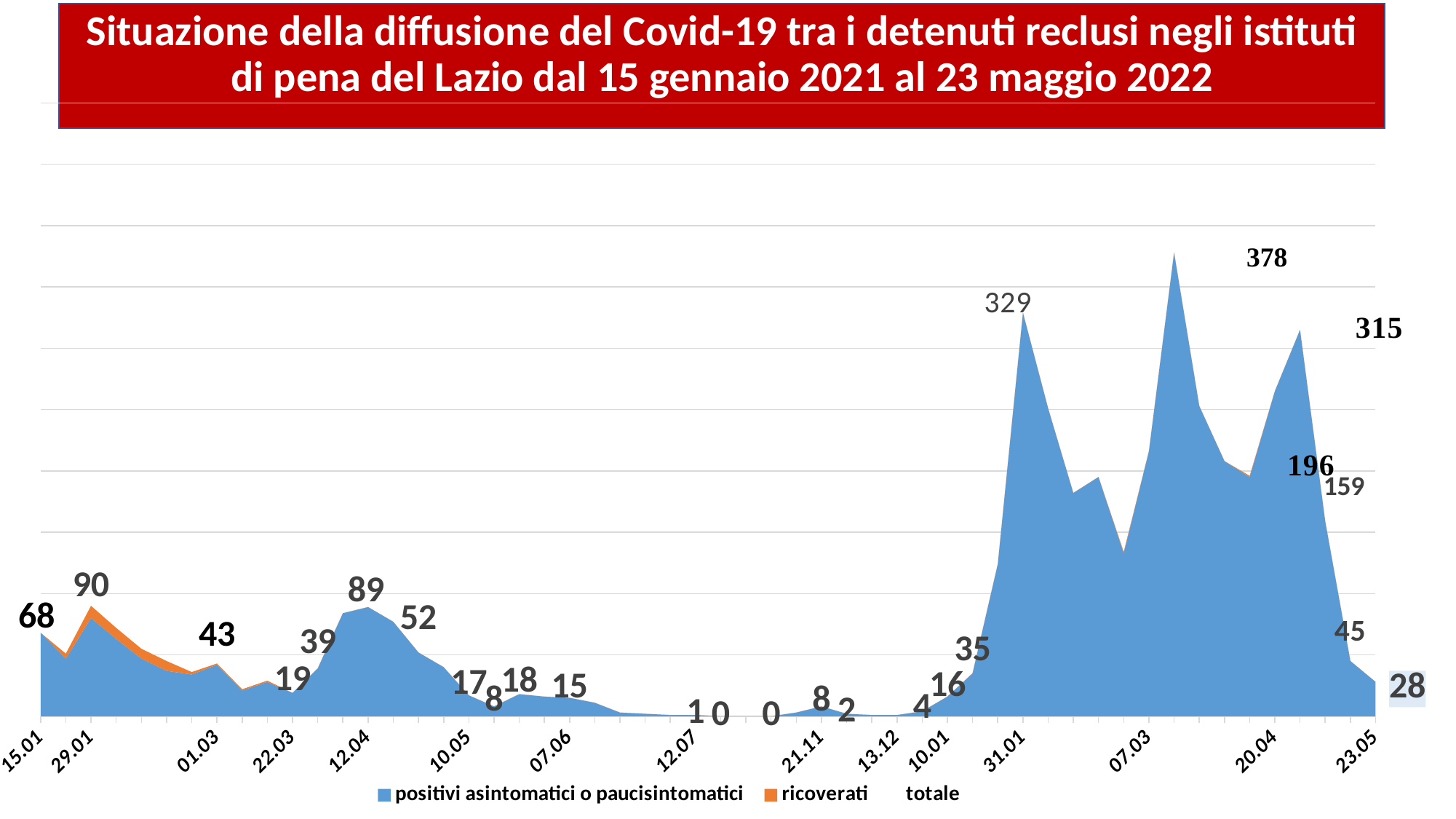
Which is larger, the value labelled at 15.01 (68) or the value labelled at 29.01 (90)? 29.01 What is the highest value labelled on the chart? 378 What is the value labelled at 15.01, the first date on the x axis? 68 What is the lowest value labelled on the chart? 0 What is the difference between the highest labelled value (378) and the peak labelled 329? 49 What is the value labelled at the peak near 12.04? 89 Which colour represents the series 'ricoverati' in the legend? orange How many series does the legend list? 3 Do the values rise or fall between 20.04 and 23.05? fall What is the value labelled at the peak near 31.01? 329 What is the value labelled at 23.05, the last date on the x axis? 28 What kind of chart is shown on the slide? area chart